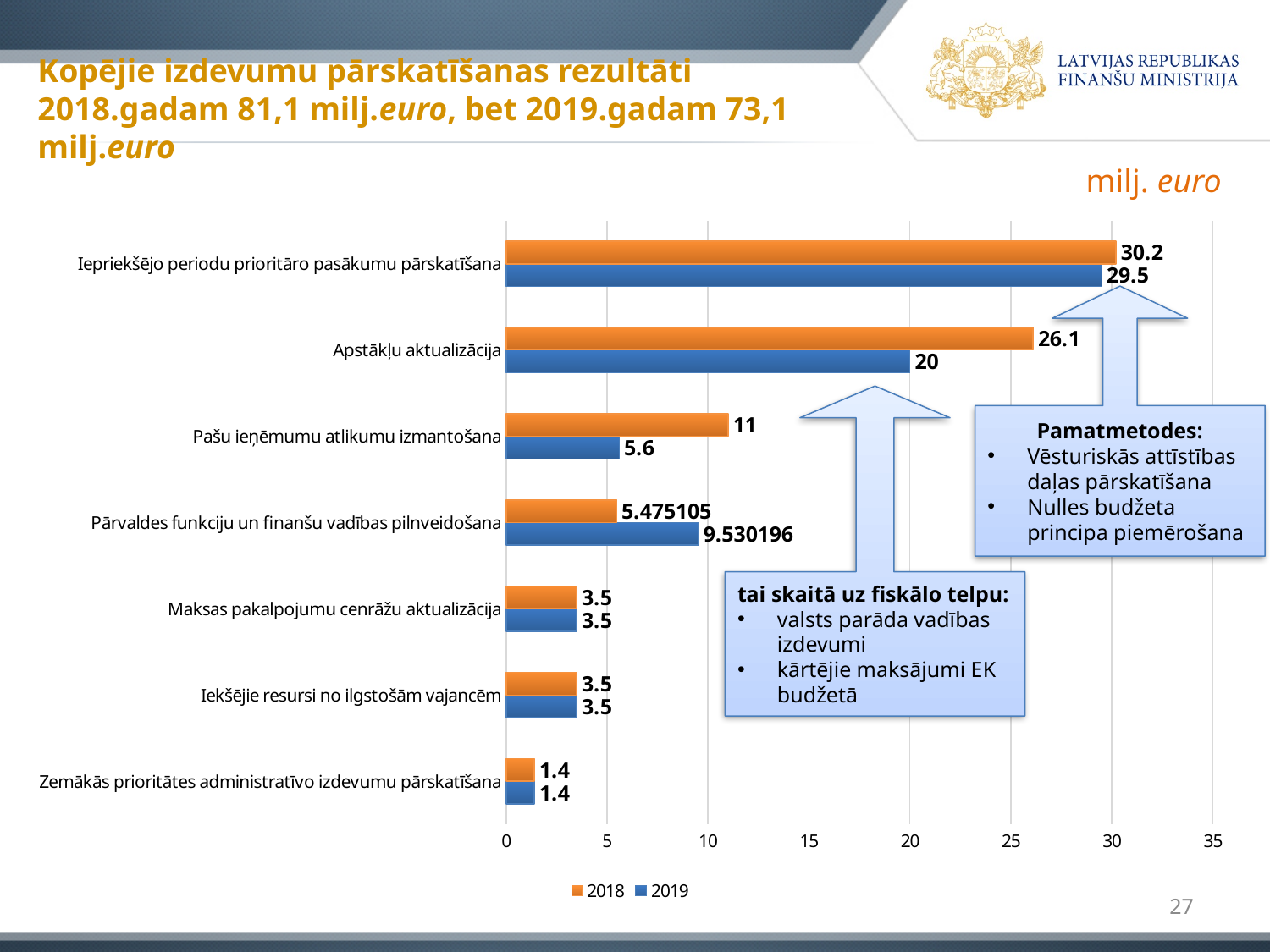
How many series does the legend list? 2 What unit label is shown above the chart? milj. euro For "Pārvaldes funkciju un finanšu vadības pilnveidošana", which year has the larger value, 2018 or 2019? 2019 Which category has the highest 2018 value? Iepriekšējo periodu prioritāro pasākumu pārskatīšana Which category has the lowest 2019 value? Zemākās prioritātes administratīvo izdevumu pārskatīšana What kind of chart is shown on the slide? Bar chart What is the 2018 value for "Iepriekšējo periodu prioritāro pasākumu pārskatīšana"? 30.2 What is the 2019 value for "Apstākļu aktualizācija"? 20 What is the difference between the 2018 and 2019 values for "Pašu ieņēmumu atlikumu izmantošana"? 5.4 What is the 2019 value for "Pārvaldes funkciju un finanšu vadības pilnveidošana"? 9.530196 How many categories are shown on the chart? 7 Is the 2018 value for "Apstākļu aktualizācija" greater or less than 25? greater